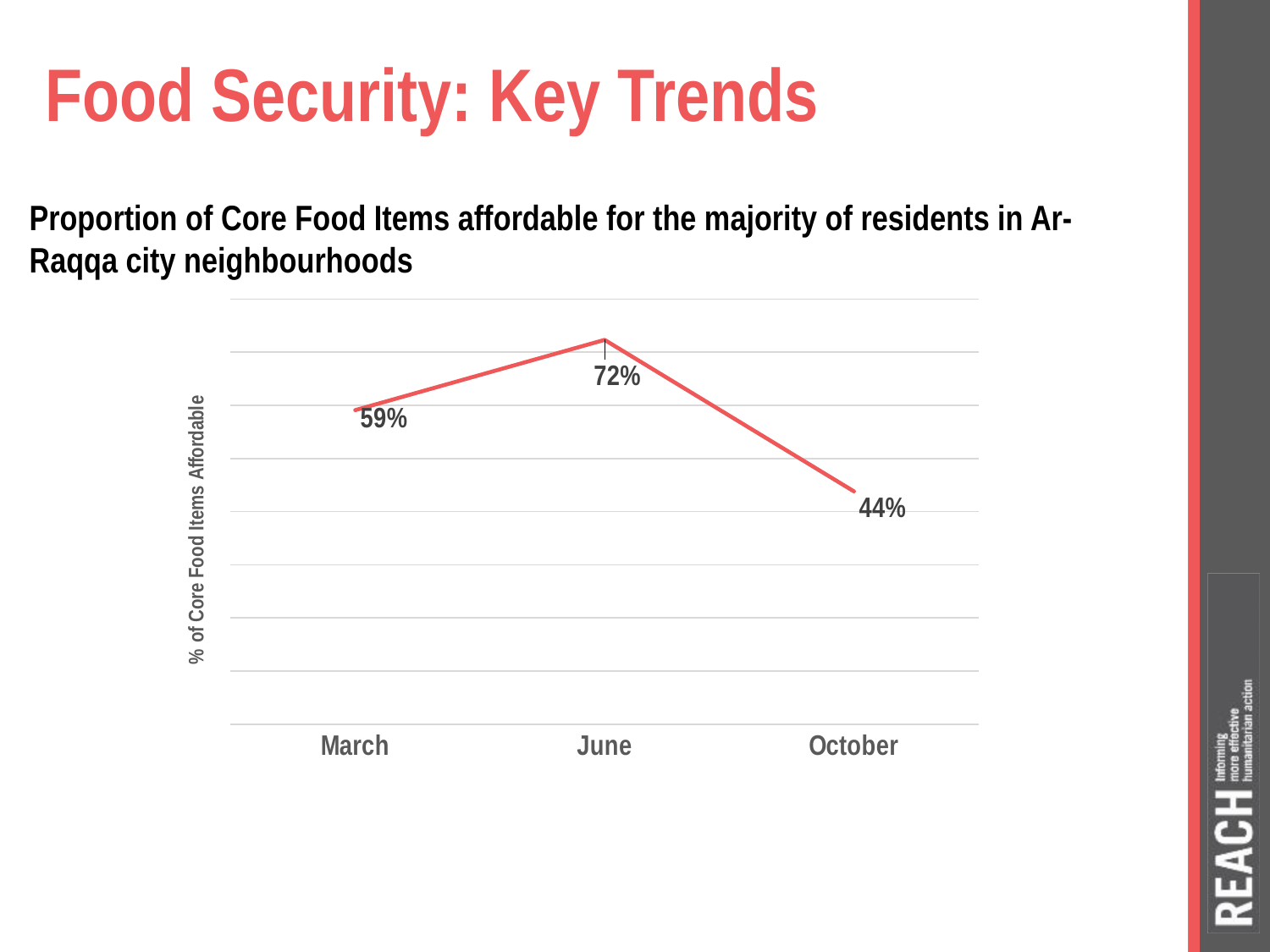
Which is larger, the value for March or the value for October? March What is the difference between the values for March and June? 13% What is the difference between the values for June and October? 28% What is the value for March? 59% What kind of chart is shown on the slide? Line chart What is the value for October? 44% Which month has the highest proportion of core food items affordable? June Which month has the lowest proportion of core food items affordable? October What is the value for June? 72% What is the label on the vertical axis of the chart? % of Core Food Items Affordable Does the value rise or fall from June to October? Fall How many months are plotted on the chart? 3